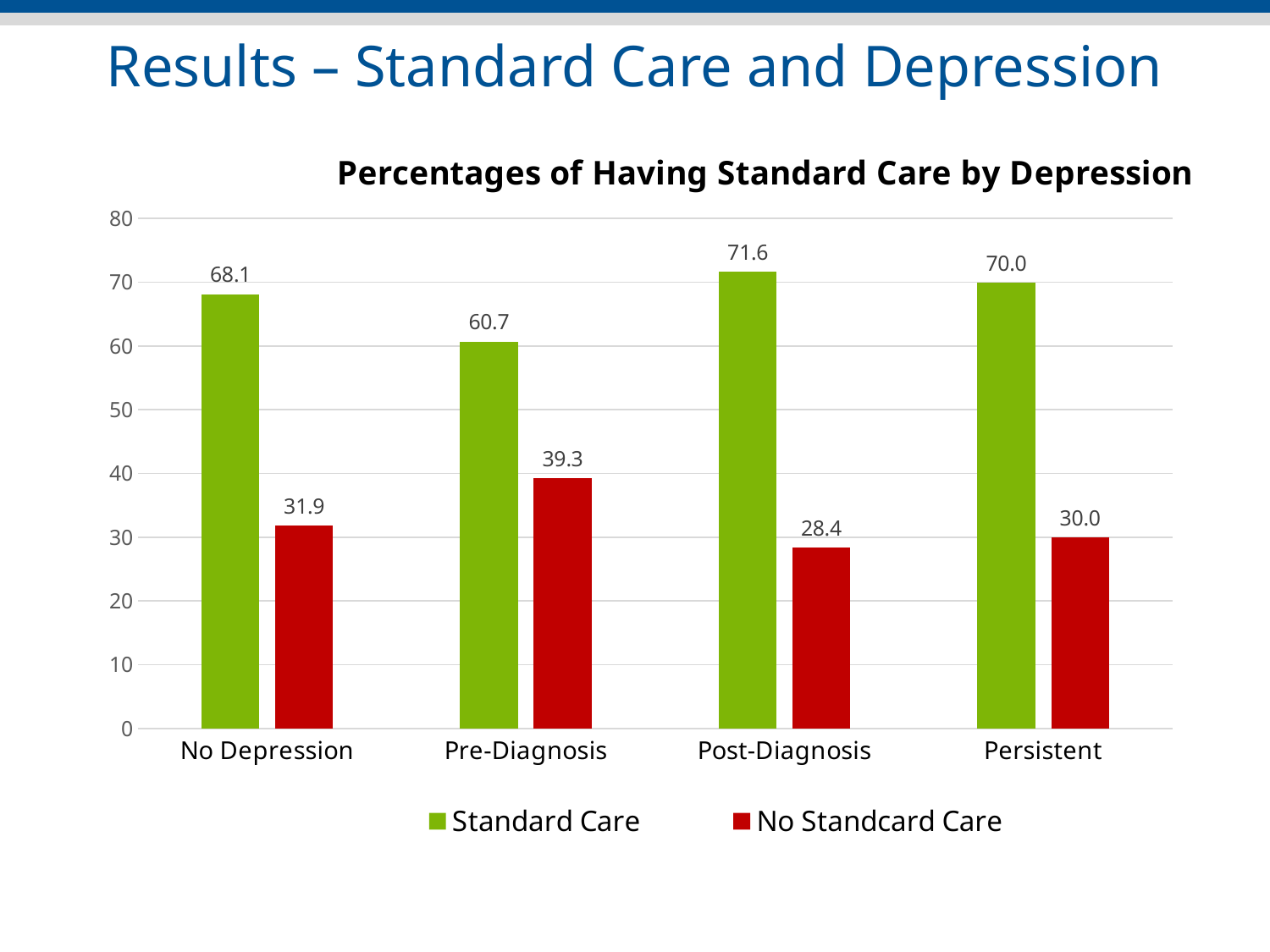
What is the difference between the Standard Care and No Standcard Care values for No Depression? 36.2 Is the No Standcard Care value for Pre-Diagnosis greater or less than 40? less What is the No Standcard Care value for the Post-Diagnosis category? 28.4 Which is larger: the Standard Care value for No Depression or the Standard Care value for Persistent? Persistent Which category has the highest Standard Care value? Post-Diagnosis Which category has the highest No Standcard Care value? Pre-Diagnosis How many series does the legend list? 2 What is the Standard Care value for the Persistent category? 70.0 What is the Standard Care value for the Pre-Diagnosis category? 60.7 What kind of chart is shown on the slide? bar chart How many categories are shown on the x axis? 4 Which category has the lowest Standard Care value? Pre-Diagnosis